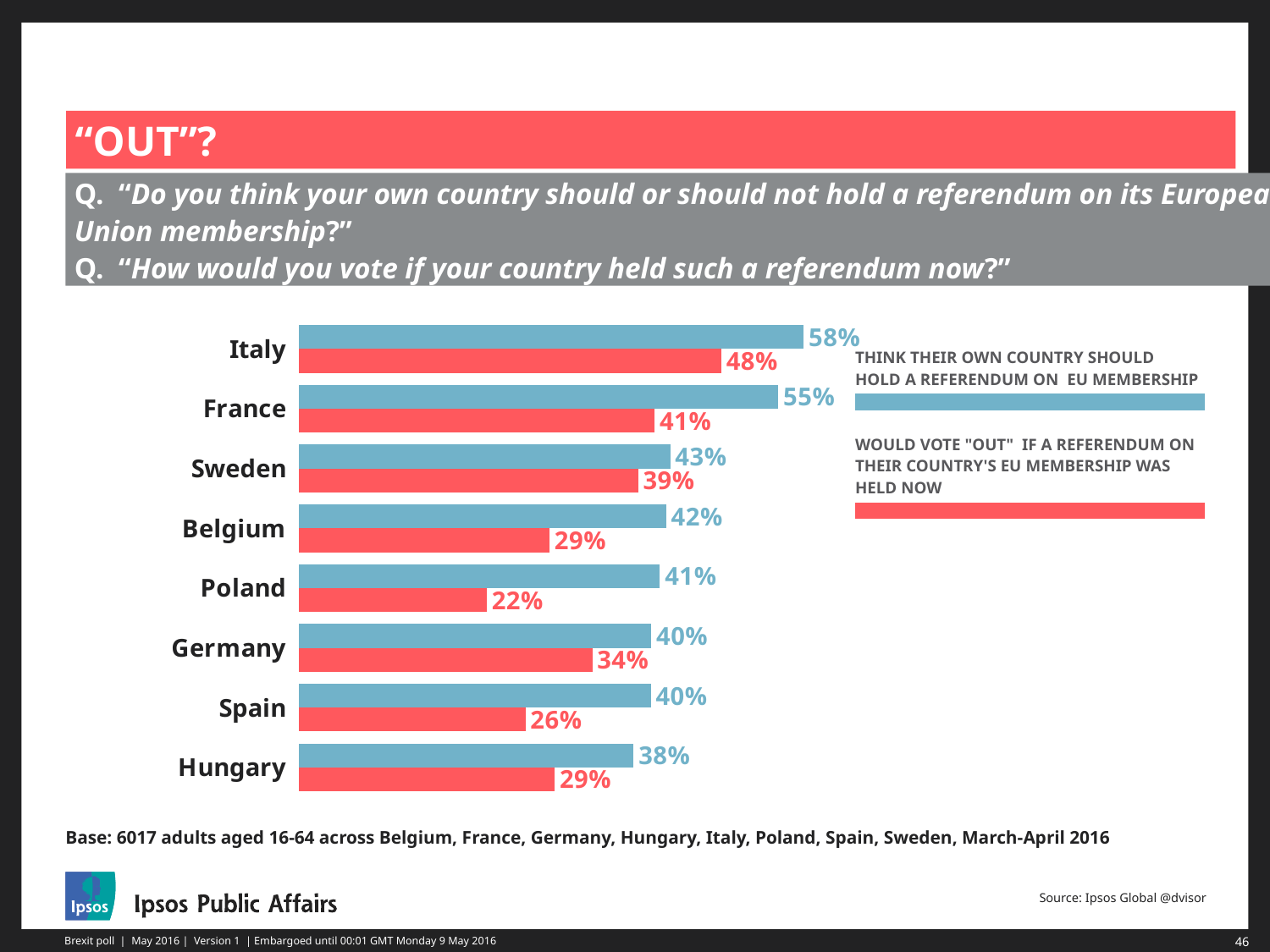
What is the difference between Italy's and Hungary's shares of respondents who would vote "Out"? 19 percentage points Which country has the highest share of respondents who think their country should hold a referendum on EU membership? Italy Which country has a larger share of respondents who would vote "Out": Germany or Spain? Germany What percentage of respondents in Italy think their own country should hold a referendum on EU membership? 58% How many series does the legend list? 2 What percentage of respondents in Poland would vote "Out" if a referendum on their country's EU membership was held now? 22% What kind of chart is shown on the slide? Bar chart Which country has the lowest share of respondents who think their country should hold a referendum on EU membership? Hungary What is the difference between the share in France who think their country should hold a referendum and the share who would vote "Out"? 14 percentage points What colour are the bars representing those who would vote "Out" if a referendum was held now? Red How many countries are shown in the chart? 8 Which country has the lowest share of respondents who would vote "Out" in a referendum held now? Poland